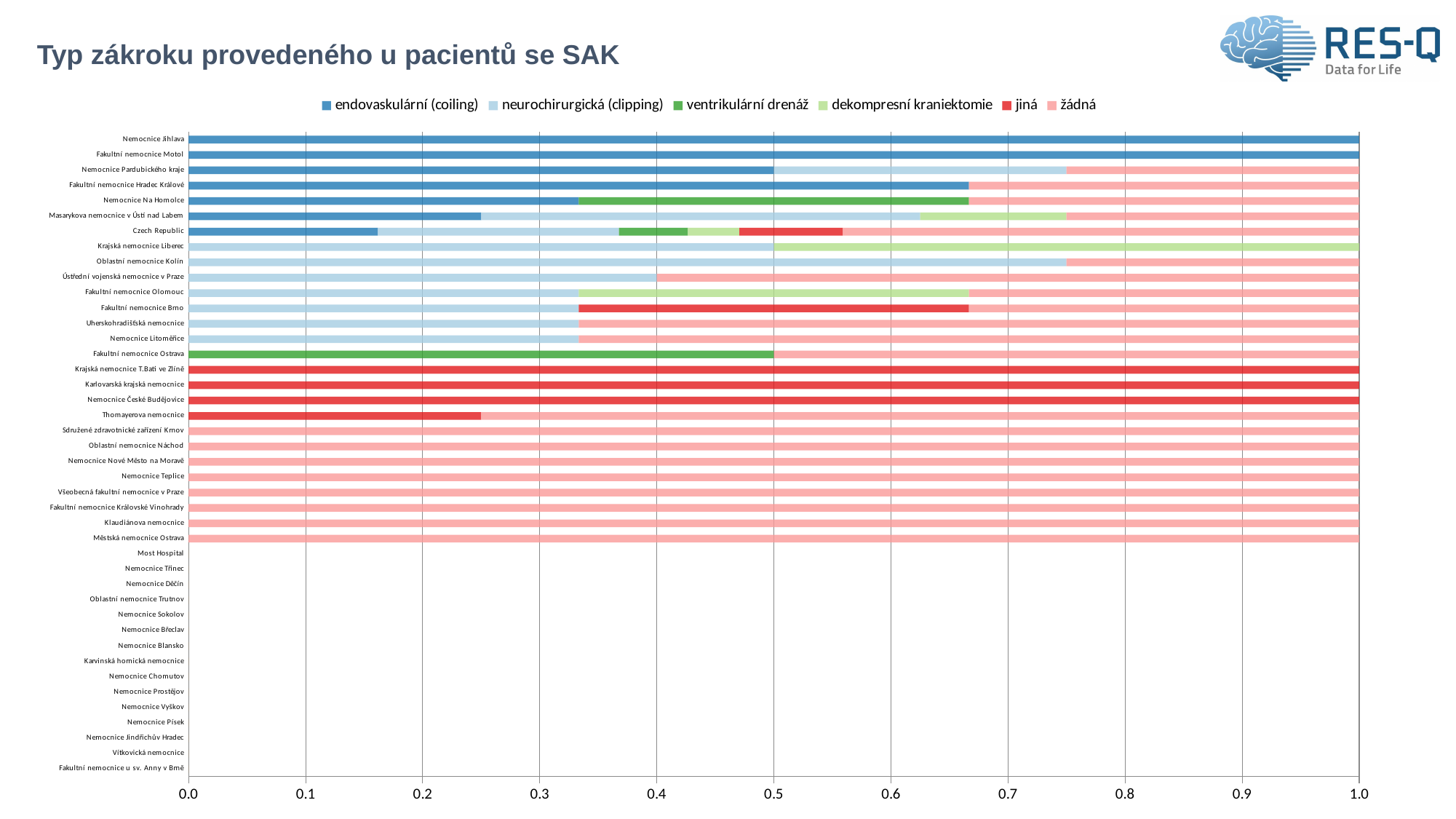
What kind of chart is shown on the slide? bar chart What is the value of endovaskulární (coiling) for Nemocnice Jihlava? 1.0 What is the value of ventrikulární drenáž for Fakultní nemocnice Ostrava? 0.5 Which has the larger endovaskulární (coiling) value, Nemocnice Pardubického kraje or Czech Republic? Nemocnice Pardubického kraje What is the value of neurochirurgická (clipping) for Ústřední vojenská nemocnice v Praze? 0.4 What is the title of the chart? Typ zákroku provedeného u pacientů se SAK How many series does the legend list? 6 Is the value of endovaskulární (coiling) for Fakultní nemocnice Hradec Králové greater or less than 0.6? greater What is the value of jiná for Krajská nemocnice T.Bati ve Zlíně? 1.0 Is the value of endovaskulární (coiling) for Czech Republic greater or less than 0.2? less What is the value of endovaskulární (coiling) for Nemocnice Pardubického kraje? 0.5 What is the value of neurochirurgická (clipping) for Krajská nemocnice Liberec? 0.5